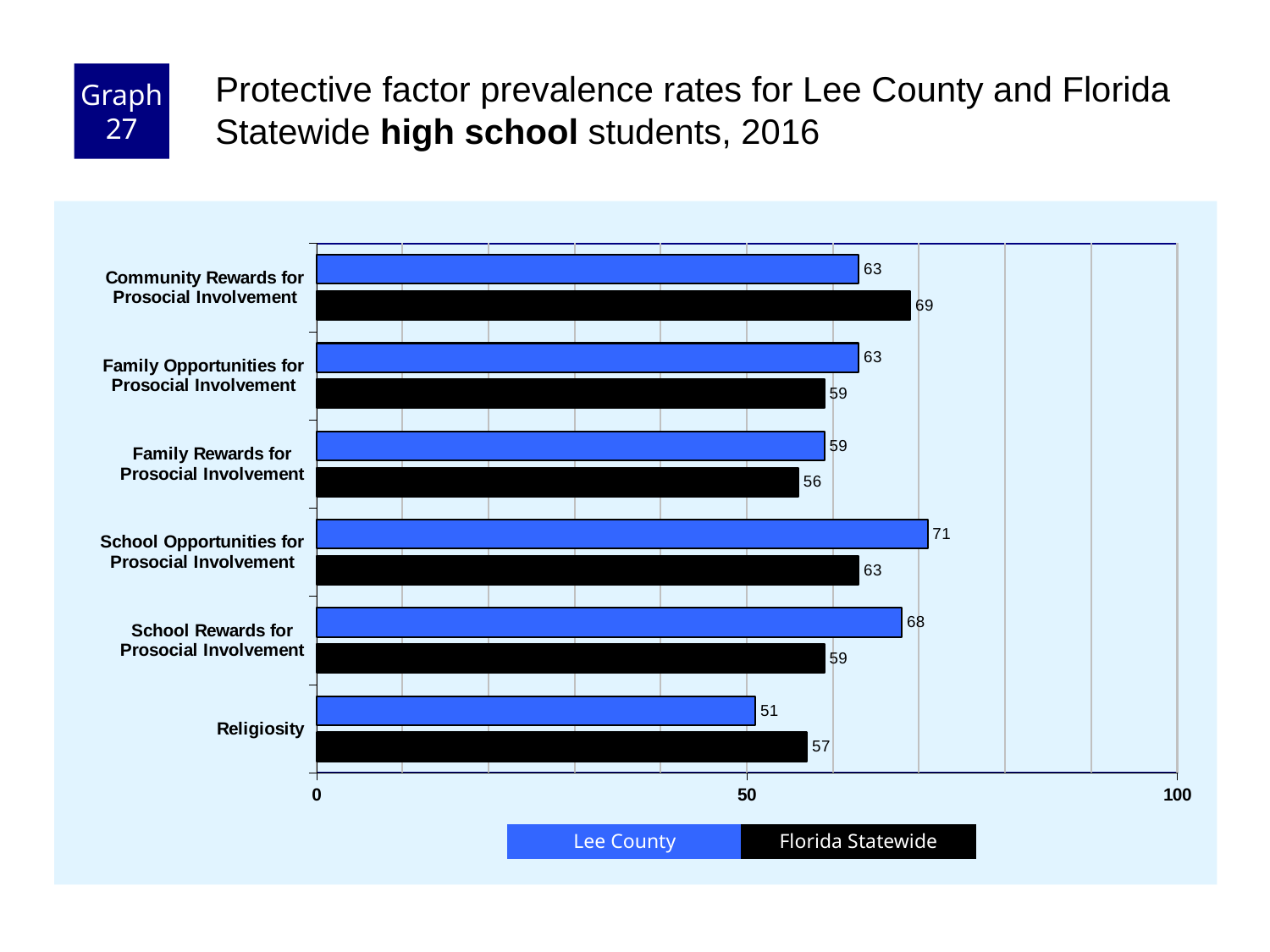
Which category has the highest Lee County value? School Opportunities for Prosocial Involvement Is the Lee County value for Religiosity greater or less than 50? greater What is the Florida Statewide value for Community Rewards for Prosocial Involvement? 69 Which category has the lowest Florida Statewide value? Family Rewards for Prosocial Involvement What is the Florida Statewide value for Religiosity? 57 What kind of chart is shown on the slide? bar chart Which category has the lowest Lee County value? Religiosity Which is larger for Religiosity, the Lee County value or the Florida Statewide value? Florida Statewide How many categories are shown on the chart? 6 What is the difference between the Lee County and Florida Statewide values for School Rewards for Prosocial Involvement? 9 What is the Lee County value for School Opportunities for Prosocial Involvement? 71 How many series does the legend list? 2